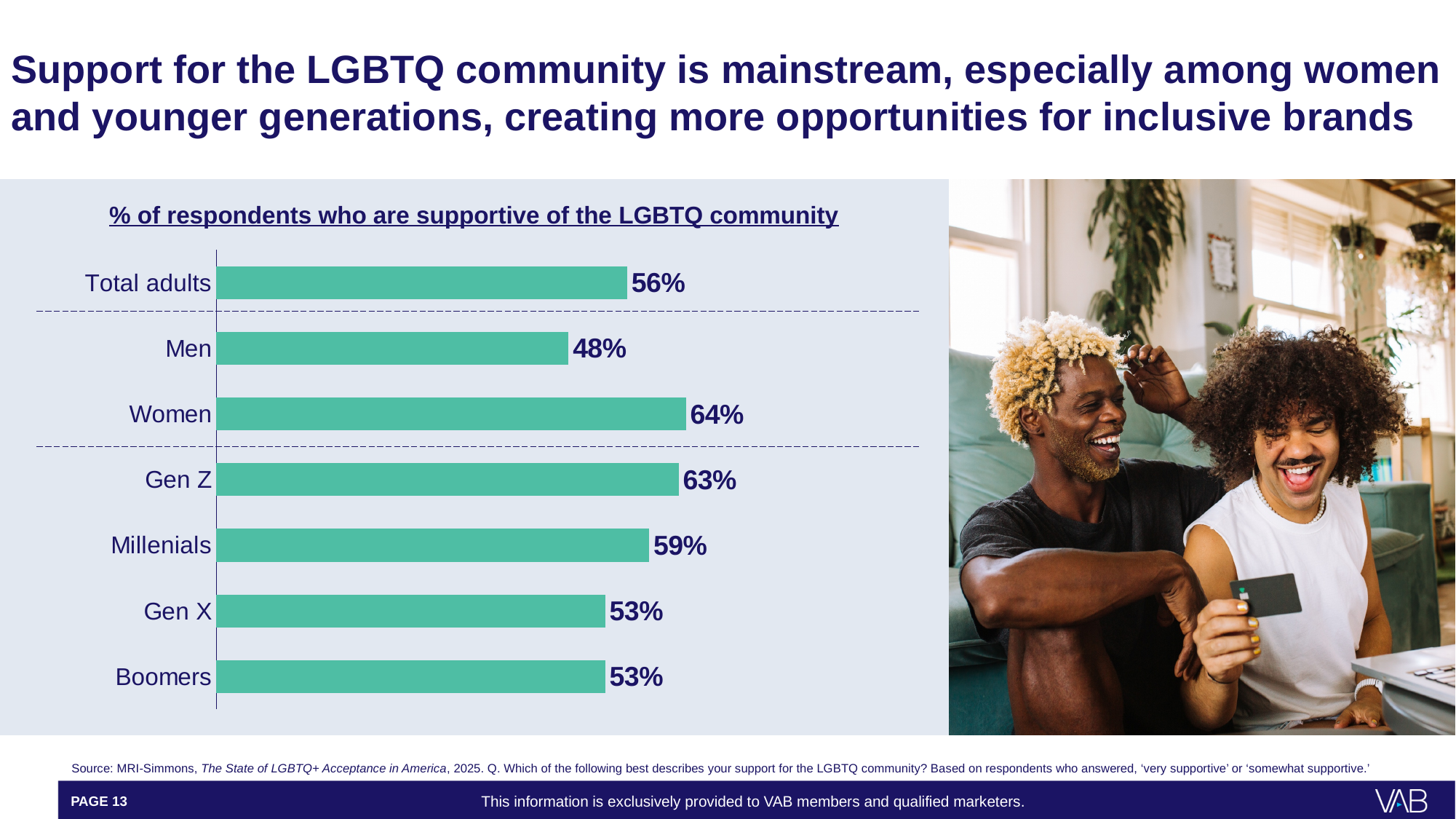
What is the title of the chart? % of respondents who are supportive of the LGBTQ community What is the value shown for Millenials? 59% What is the value shown for Women? 64% What kind of chart is shown on the slide? Bar chart How many categories are shown in the chart? 7 Which category has the highest value in the chart? Women What is the difference between the values for Women and Men? 16% What percentage of Total adults are supportive of the LGBTQ community? 56% What is the difference between the values for Gen Z and Gen X? 10% What is the value shown for Gen Z? 63% Which category has the lowest value in the chart? Men Which is larger, the value for Millenials or the value for Boomers? Millenials